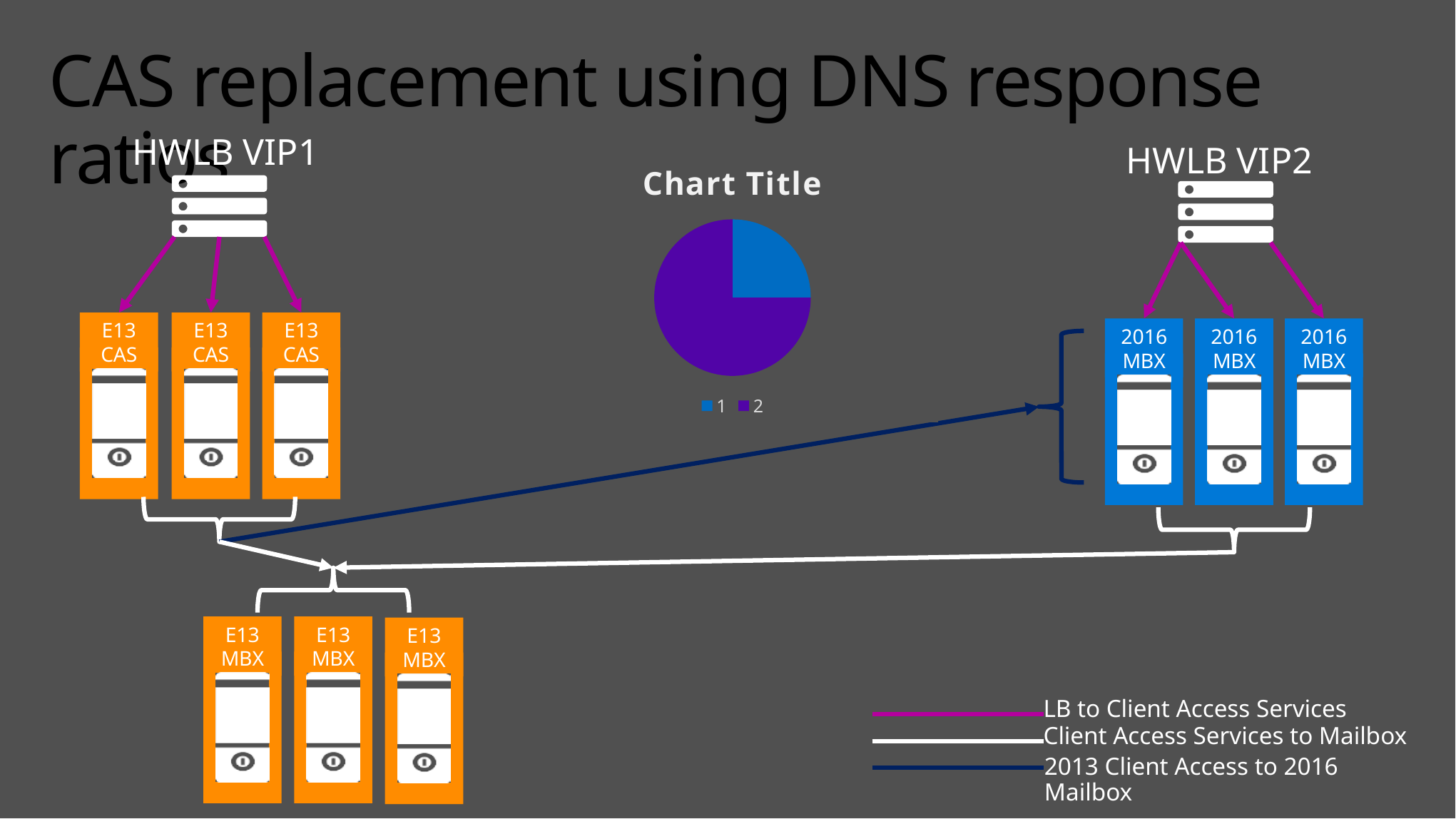
What kind of chart is shown on the slide? pie chart What colour is the slice labelled 2 in the pie chart? purple Which slice of the pie chart is the smallest? 1 Which slice is larger in the pie chart, 1 or 2? 2 How many slices does the pie chart have? 2 How many entries does the chart's legend list? 2 Which slice of the pie chart is the largest? 2 What is the title of the chart? Chart Title